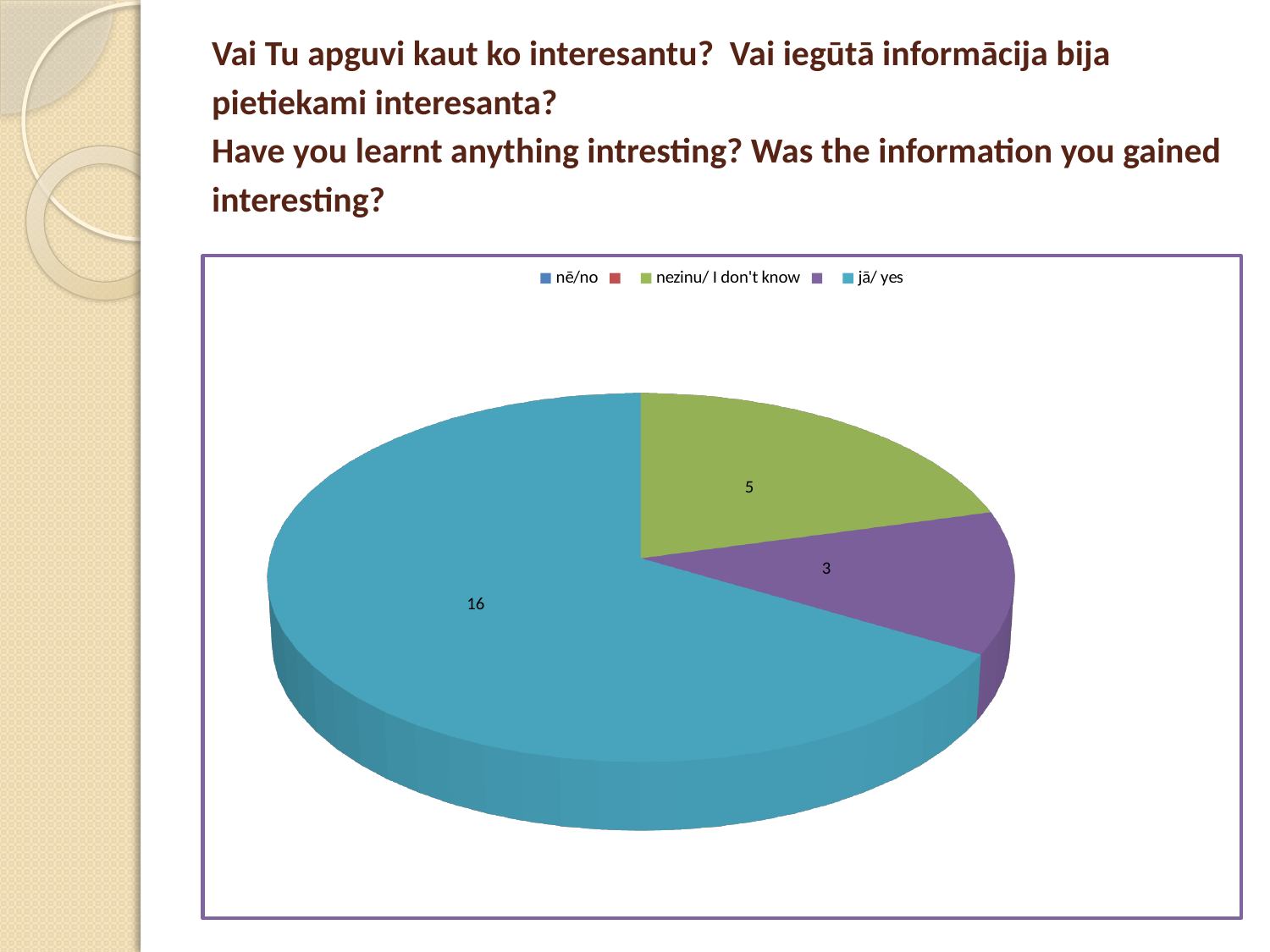
Which category has the largest slice in the pie chart? jā/ yes Which is larger in the pie chart: "jā/ yes" or "nezinu/ I don't know"? jā/ yes What type of chart is shown on the slide? Pie chart Which legend entry in the pie chart corresponds to the green slice? nezinu/ I don't know What value is shown for the "nezinu/ I don't know" slice of the pie chart? 5 What is the smallest value printed on the pie chart? 3 Which legend entry in the pie chart corresponds to the light blue slice? jā/ yes What is the total of all the values printed on the pie chart? 24 How many slices with data labels are visible in the pie chart? 3 What is the difference between the "jā/ yes" value and the "nezinu/ I don't know" value in the pie chart? 11 What value is shown for the "jā/ yes" slice of the pie chart? 16